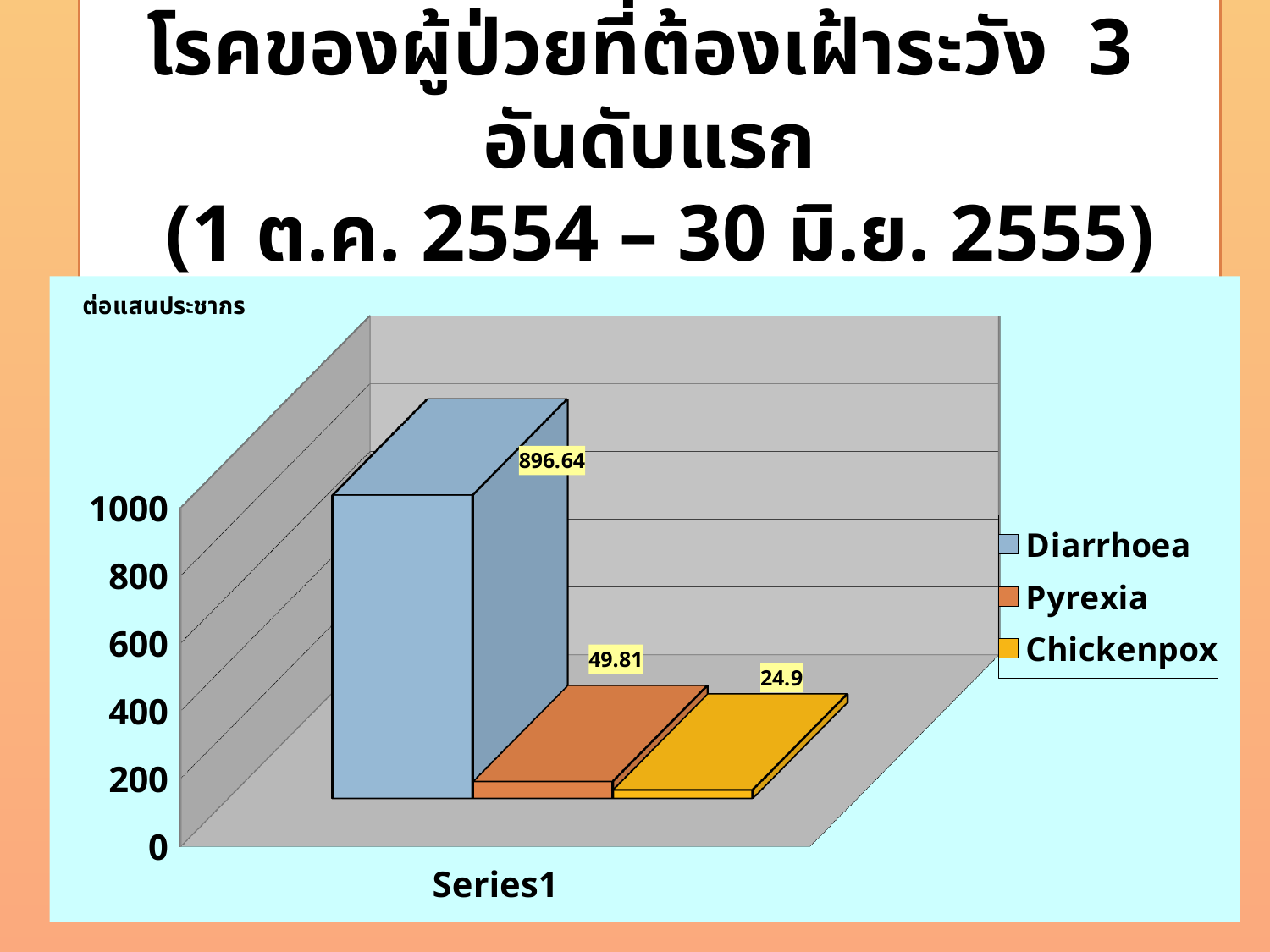
How many series does the legend list? 3 What is the difference between the values for Diarrhoea and Pyrexia? 846.83 Is the value for Diarrhoea greater or less than 800? greater What is the difference between the values for Pyrexia and Chickenpox? 24.91 Which disease has the highest value? Diarrhoea Which disease has the lowest value? Chickenpox What is the value shown for Chickenpox? 24.9 What is the value shown for Diarrhoea? 896.64 What label appears on the category axis below the bars? Series1 Which is larger, the value for Pyrexia or the value for Chickenpox? Pyrexia What kind of chart is shown on the slide? bar chart What is the value shown for Pyrexia? 49.81